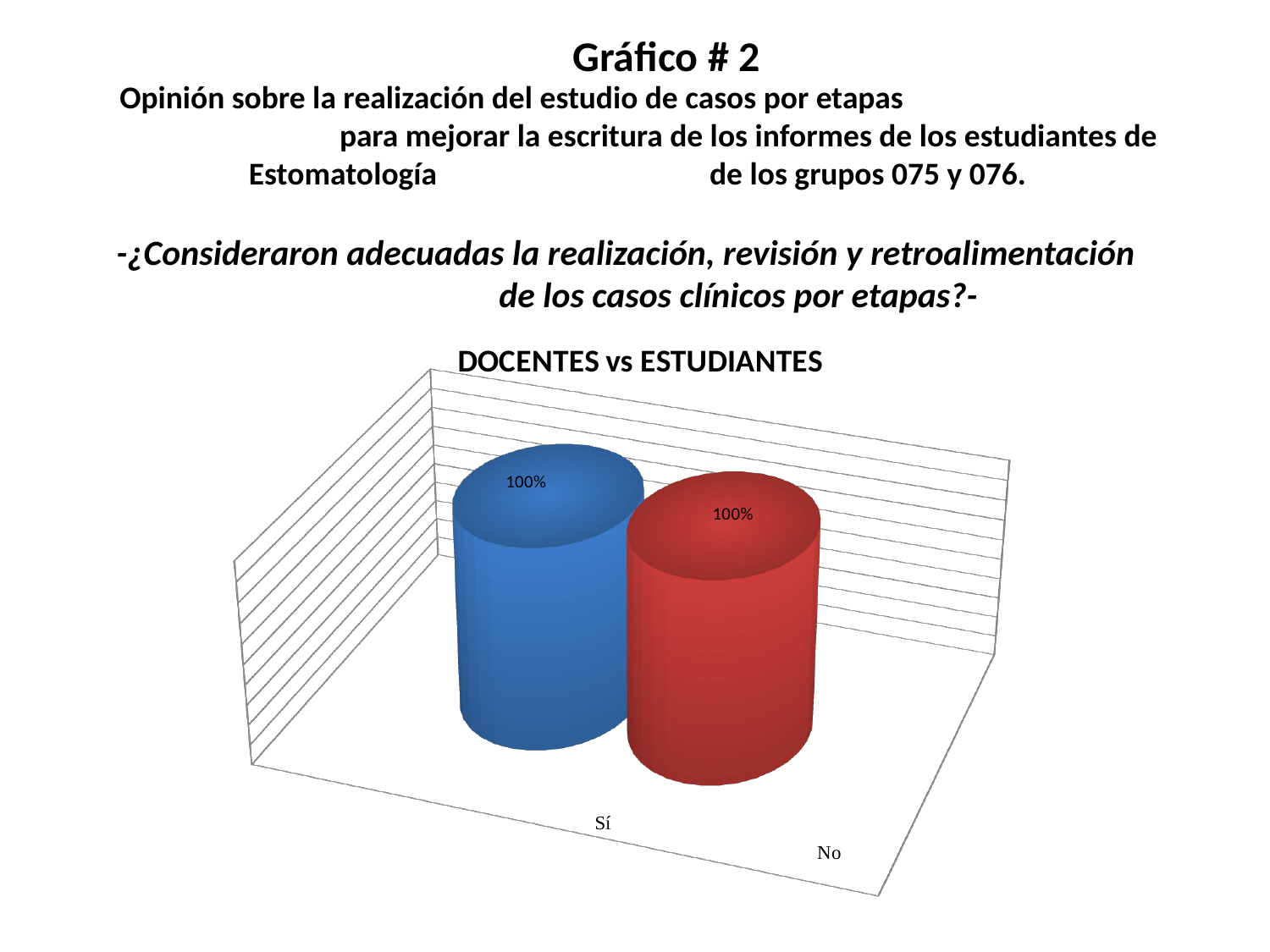
How many bars are plotted in the chart? 2 Are any bars plotted for the category No? No What is the title of the chart? DOCENTES vs ESTUDIANTES What is the difference between the blue bar and the red bar for the category Sí? 0% What kind of chart is shown on the slide? Bar chart How many categories are shown on the x axis of the chart? 2 Which category has bars plotted in the chart? Sí Do the blue and red bars for the category Sí show the same value? Yes What value is labelled on the red bar for the category Sí? 100% What value is labelled on the blue bar for the category Sí? 100% What are the category labels on the x axis of the chart? Sí and No